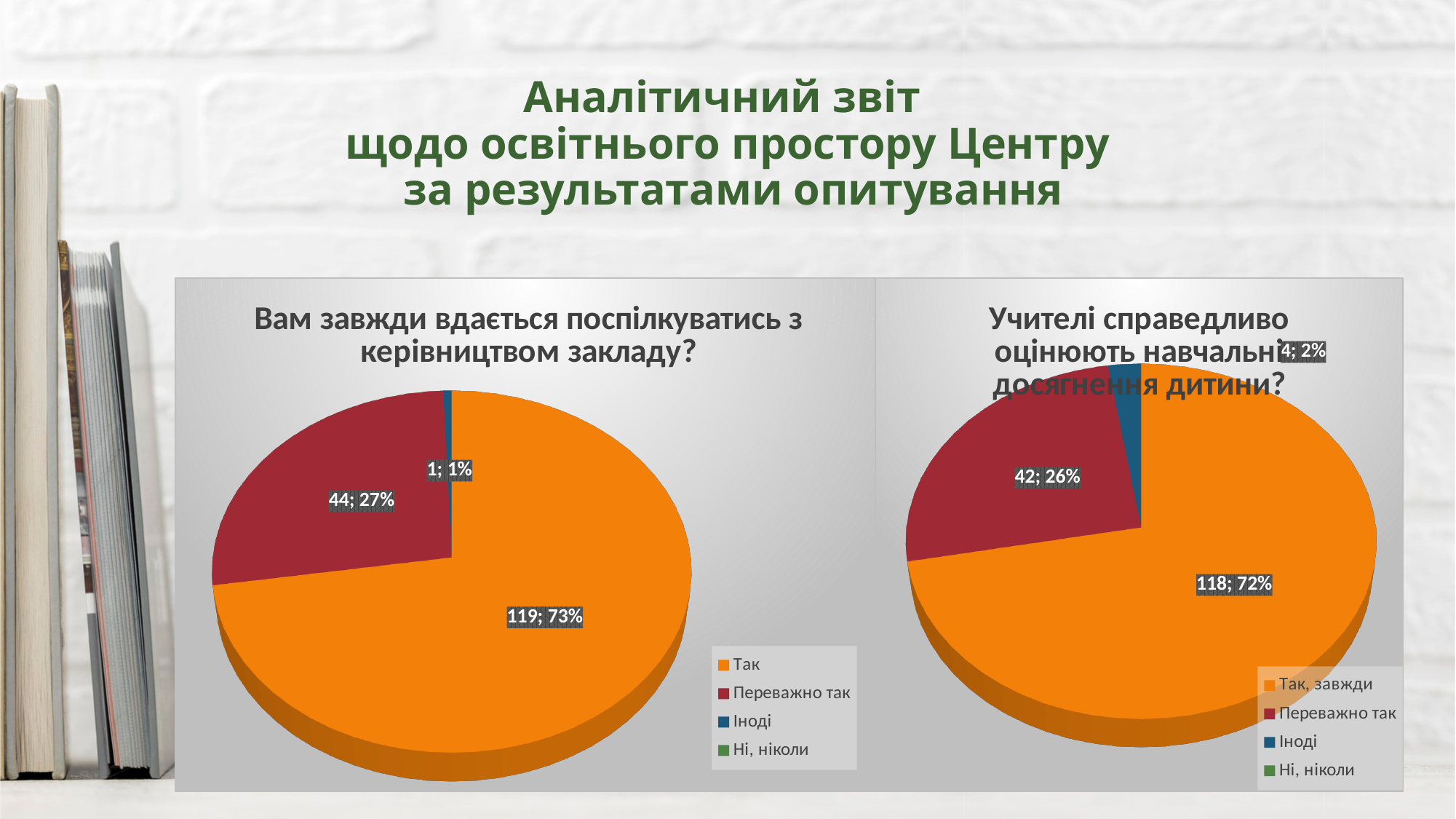
Which is larger: the "Переважно так" count in the left chart or the "Переважно так" count in the right chart? Left chart (44) In the left chart ("Вам завжди вдається поспілкуватись з керівництвом закладу?"), what is the data label for the "Так" slice? 119; 73% What kind of chart is used on the left, titled "Вам завжди вдається поспілкуватись з керівництвом закладу?"? Pie chart In the right chart ("Учителі справедливо оцінюють навчальні досягнення дитини?"), which labelled answer has the smallest slice? Іноді In the right chart ("Учителі справедливо оцінюють навчальні досягнення дитини?"), how many responses are labelled for "Переважно так"? 42 In the left chart ("Вам завжди вдається поспілкуватись з керівництвом закладу?"), what is the difference in count between "Так" and "Переважно так"? 75 How many entries does the legend of the right chart ("Учителі справедливо оцінюють навчальні досягнення дитини?") list? 4 In the right chart ("Учителі справедливо оцінюють навчальні досягнення дитини?"), what percentage share does "Іноді" have? 2% In the left chart ("Вам завжди вдається поспілкуватись з керівництвом закладу?"), how many responses are labelled for "Іноді"? 1 In the right chart ("Учителі справедливо оцінюють навчальні досягнення дитини?"), what is the data label for the "Так, завжди" slice? 118; 72% In the left chart ("Вам завжди вдається поспілкуватись з керівництвом закладу?"), which answer has the largest slice? Так In the left chart ("Вам завжди вдається поспілкуватись з керівництвом закладу?"), what percentage share does "Переважно так" have? 27%